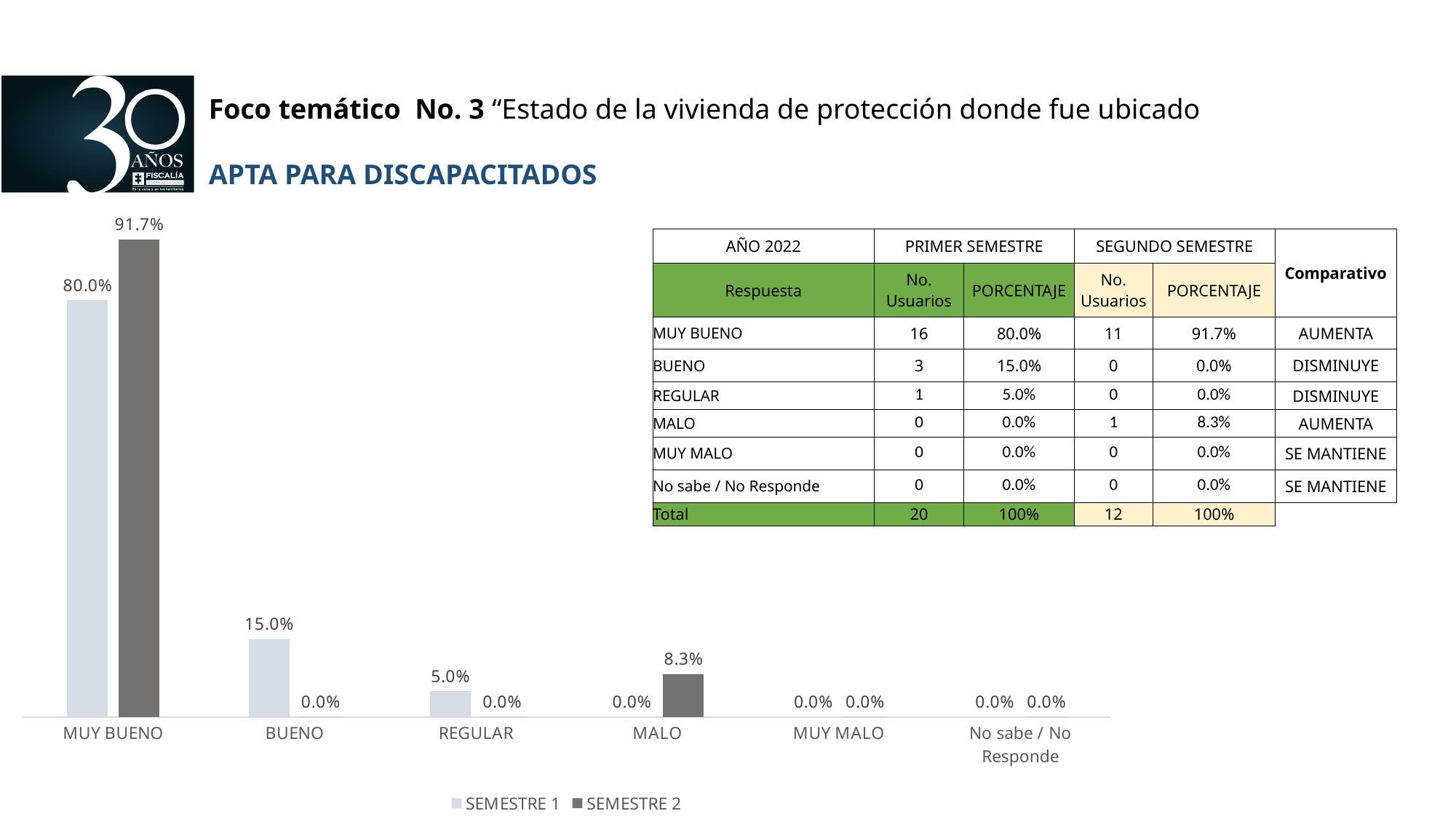
What are the two series names listed in the chart legend? SEMESTRE 1 and SEMESTRE 2 Which is larger for BUENO: the SEMESTRE 1 value or the SEMESTRE 2 value? SEMESTRE 1 What is the value for MALO in the SEMESTRE 2 series? 8.3% What is the value for BUENO in the SEMESTRE 1 series? 15.0% What kind of chart is shown on the slide? Bar chart What is the difference between the SEMESTRE 2 and SEMESTRE 1 values for MUY BUENO? 11.7% Which category has the highest value in the SEMESTRE 2 series? MUY BUENO How many categories are shown on the x axis of the chart? 6 What is the value for REGULAR in the SEMESTRE 1 series? 5.0% What is the value for MUY BUENO in the SEMESTRE 2 series? 91.7% What is the value for MUY BUENO in the SEMESTRE 1 series? 80.0% How many series does the chart legend list? 2